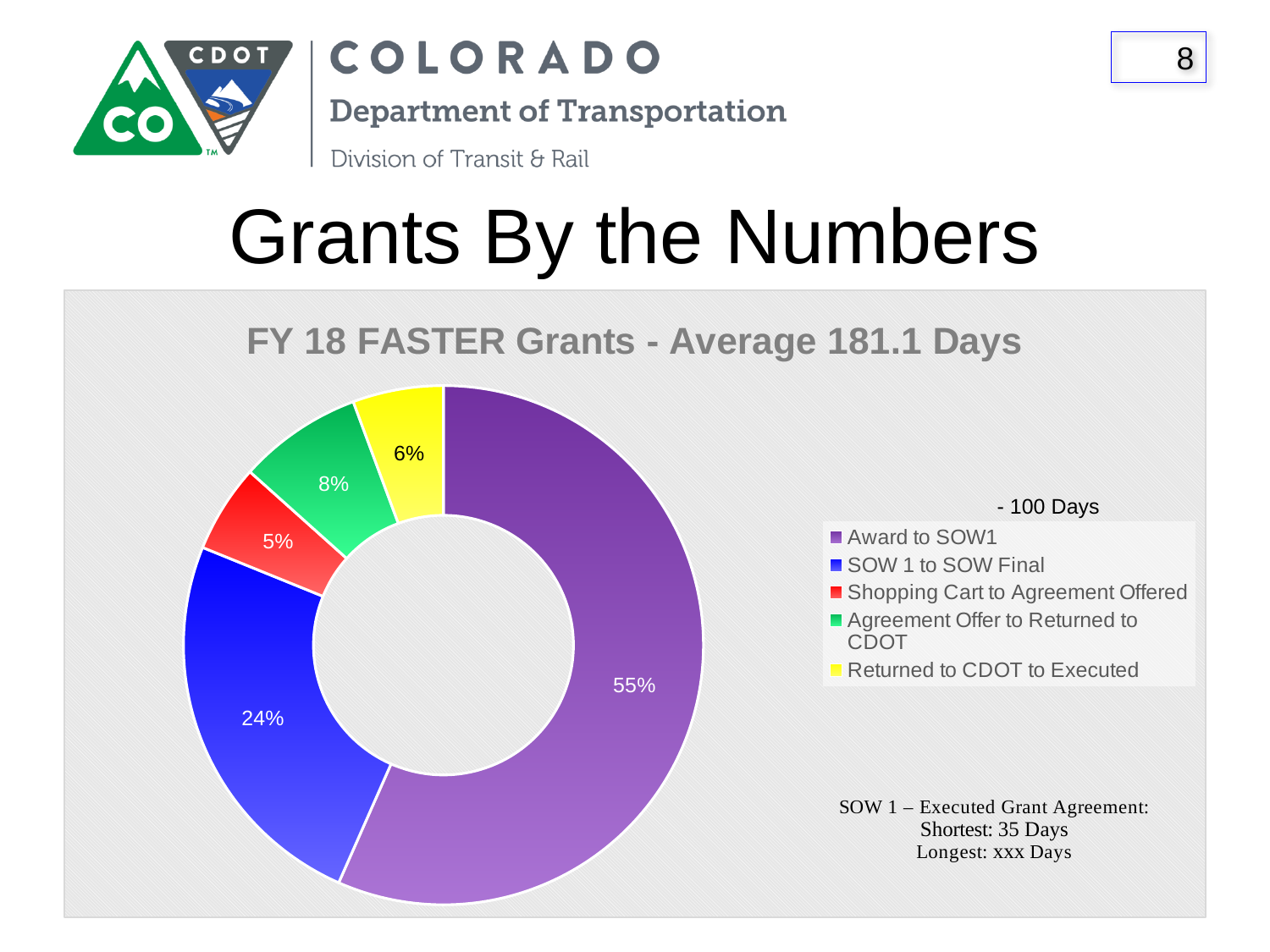
What is the title of the chart? FY 18 FASTER Grants - Average 181.1 Days Which category has the largest share of the chart? Award to SOW1 Which is larger, the share for Agreement Offer to Returned to CDOT or the share for Returned to CDOT to Executed? Agreement Offer to Returned to CDOT What share of the chart does Returned to CDOT to Executed represent? 6% What share of the chart does Agreement Offer to Returned to CDOT represent? 8% What share of the chart does SOW 1 to SOW Final represent? 24% What is the difference in percentage points between Award to SOW1 and SOW 1 to SOW Final? 31 percentage points Which category has the smallest share of the chart? Shopping Cart to Agreement Offered How many categories does the legend list? 5 What kind of chart is shown on the slide? Doughnut (pie) chart